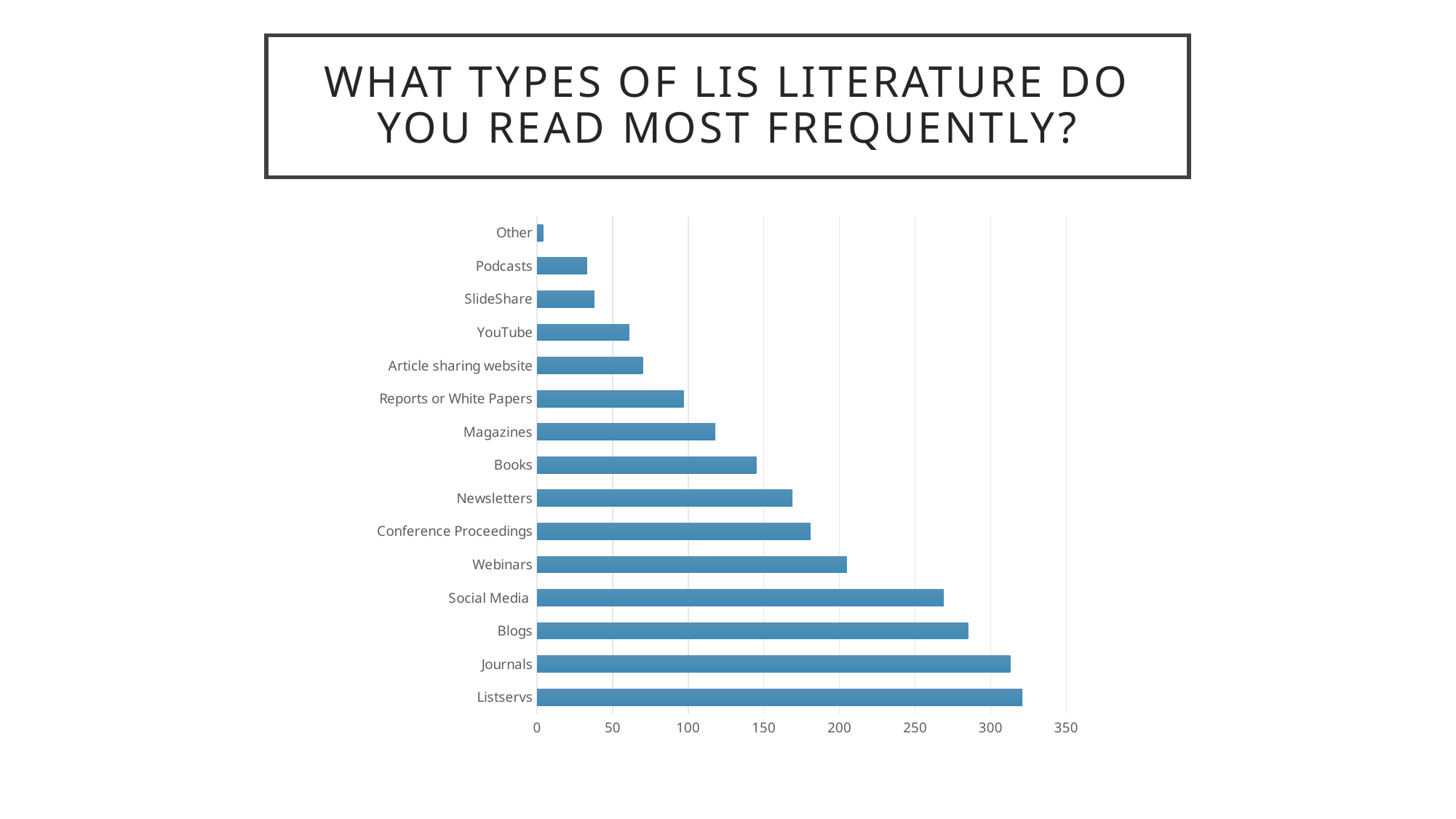
Which category has the lowest value? Other Is the value for Conference Proceedings greater or less than 200? less Which has a larger value, Blogs or Social Media? Blogs Is the value for Social Media greater or less than 250? greater Is the value for Journals greater or less than 300? greater How many categories are plotted in the chart? 15 What kind of chart is shown on the slide? bar chart Which category has the highest value? Listservs What is the title of the chart on the slide? What types of LIS literature do you read most frequently?